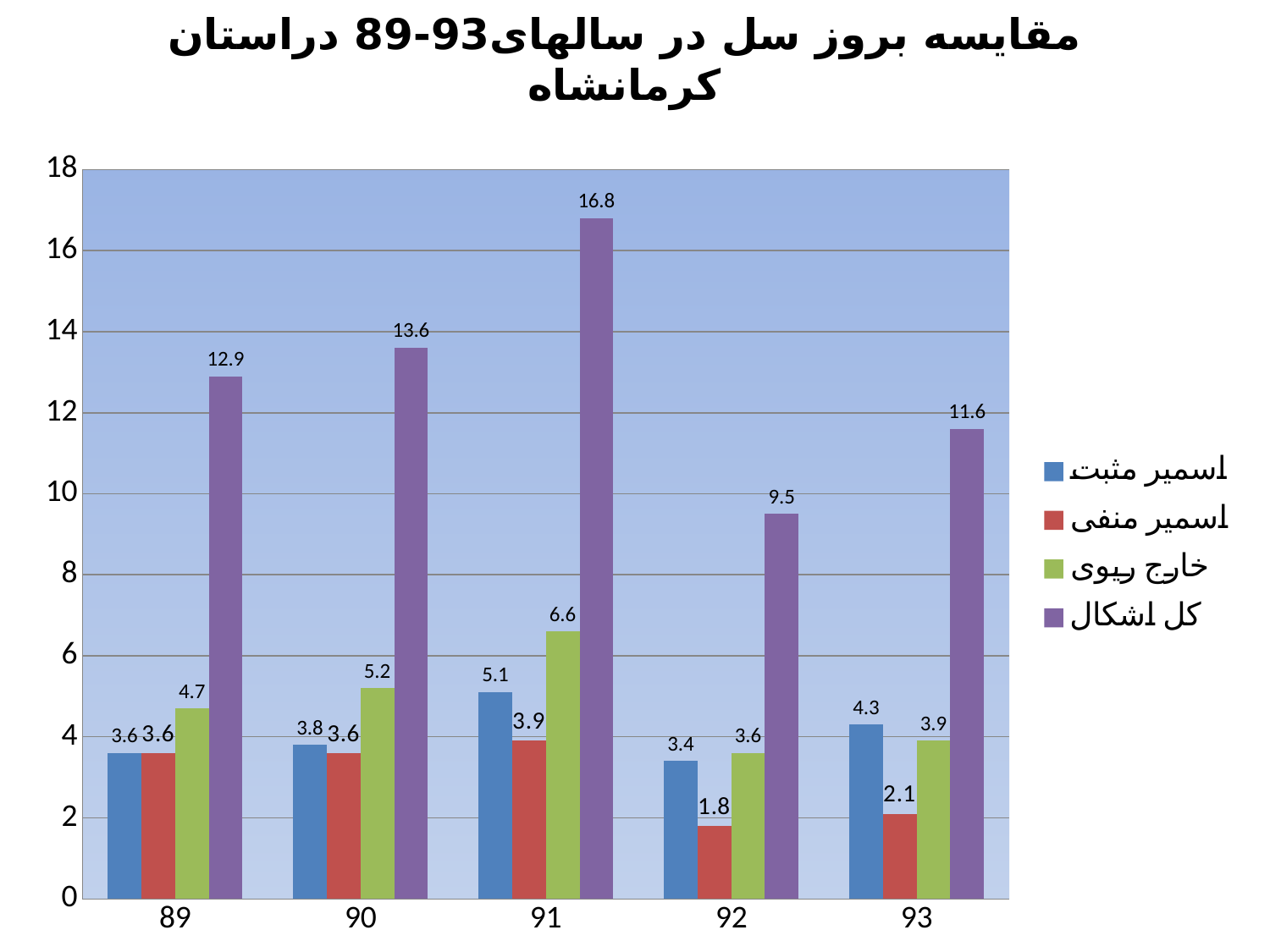
How many years are shown on the x axis? 5 What is the difference between the کل اشکال values for years 91 and 92? 7.3 Which is larger: the اسمیر مثبت value for year 91 or for year 89? Year 91 What kind of chart is shown on the slide? Bar chart In which year is the value of اسمیر منفی the lowest? 92 What is the value of کل اشکال for year 91? 16.8 What is the value of اسمیر مثبت for year 93? 4.3 How many series does the legend list? 4 Which colour represents کل اشکال in the legend? Purple In which year is the value of کل اشکال the highest? 91 What is the value of اسمیر منفی for year 92? 1.8 What is the value of خارج ریوی for year 90? 5.2